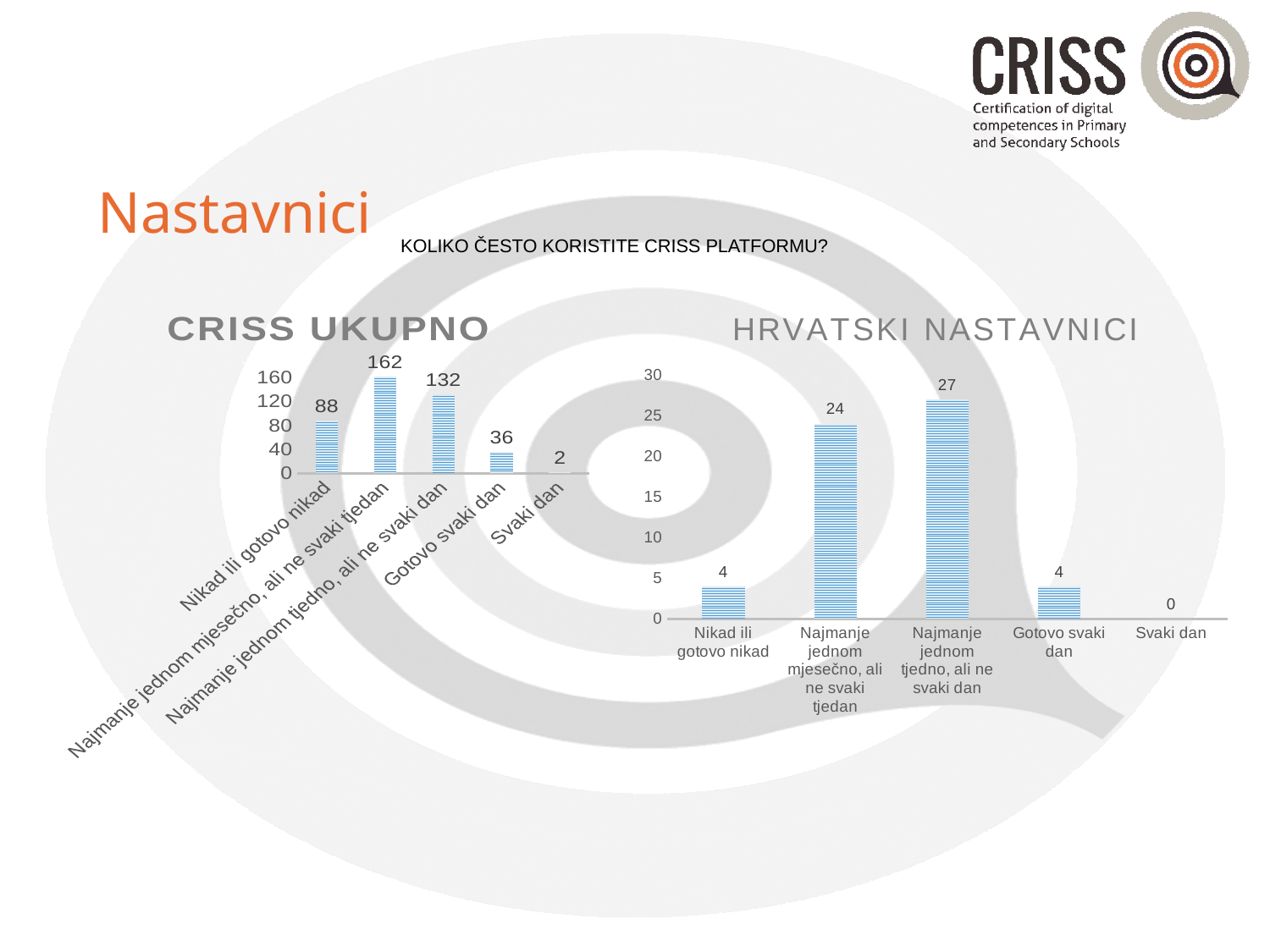
In the HRVATSKI NASTAVNICI chart, which category has the highest value? Najmanje jednom tjedno, ali ne svaki dan In the HRVATSKI NASTAVNICI chart, what is the value for "Svaki dan"? 0 In the CRISS UKUPNO chart, what is the value for "Najmanje jednom mjesečno, ali ne svaki tjedan"? 162 What kind of chart is the HRVATSKI NASTAVNICI chart? Bar chart In the CRISS UKUPNO chart, how many categories are shown? 5 What question is shown above the two charts? KOLIKO ČESTO KORISTITE CRISS PLATFORMU? In the CRISS UKUPNO chart, which category has the lowest value? Svaki dan In the CRISS UKUPNO chart, what is the value for "Nikad ili gotovo nikad"? 88 In the HRVATSKI NASTAVNICI chart, what is the value for "Najmanje jednom tjedno, ali ne svaki dan"? 27 In the CRISS UKUPNO chart, what is the difference between "Najmanje jednom tjedno, ali ne svaki dan" and "Gotovo svaki dan"? 96 In the HRVATSKI NASTAVNICI chart, what is the difference between "Najmanje jednom tjedno, ali ne svaki dan" and "Najmanje jednom mjesečno, ali ne svaki tjedan"? 3 In the HRVATSKI NASTAVNICI chart, which is larger: "Nikad ili gotovo nikad" or "Najmanje jednom mjesečno, ali ne svaki tjedan"? Najmanje jednom mjesečno, ali ne svaki tjedan